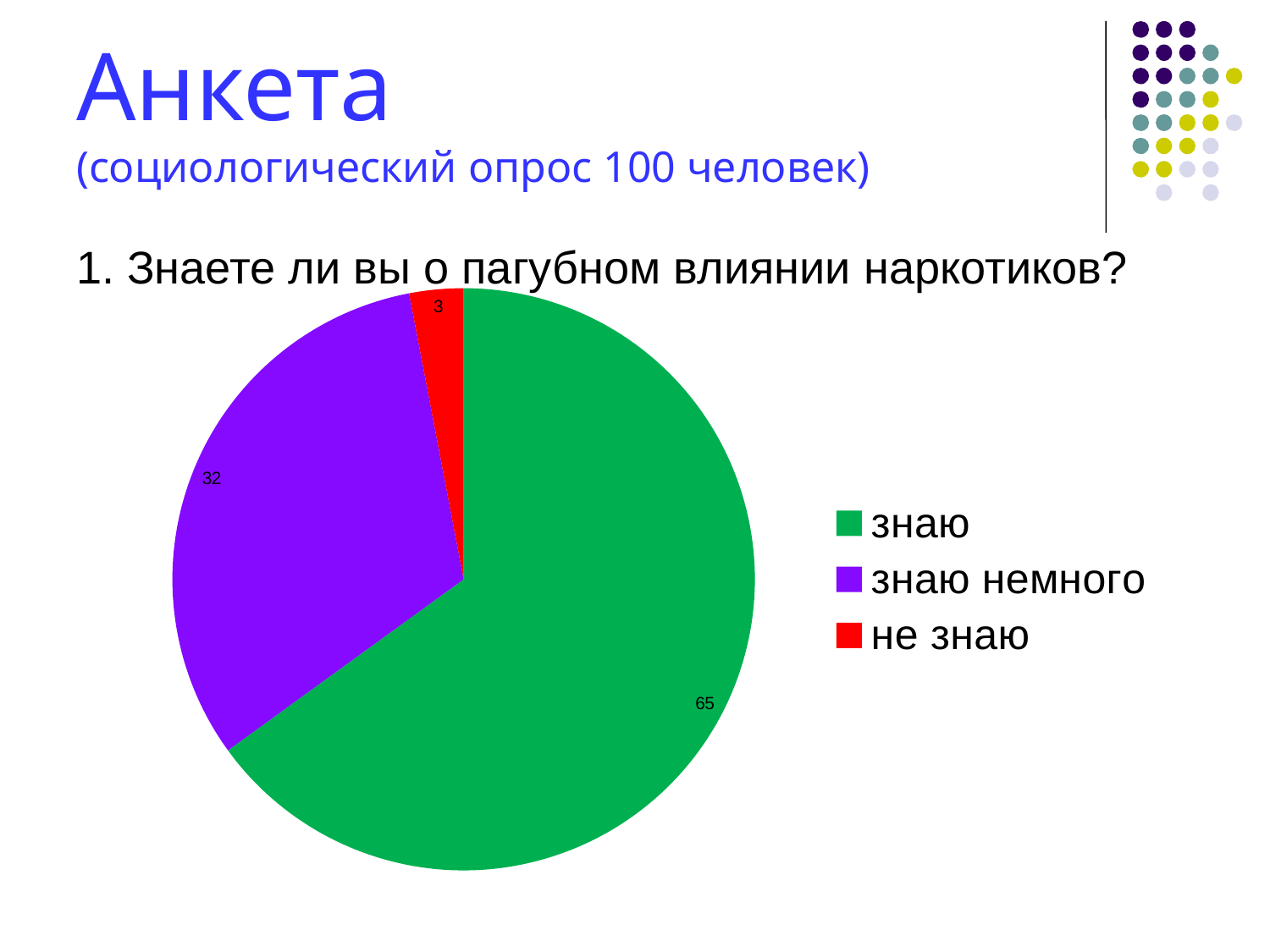
Which category has the largest slice? знаю How many slices does the pie chart have? 3 How many entries does the legend list? 3 What colour is the slice for "не знаю"? red What is the value for "знаю"? 65 What is the difference between the values for "знаю" and "знаю немного"? 33 What share of the pie does "знаю" represent? 65% What is the value for "не знаю"? 3 Which is larger, the value for "знаю немного" or the value for "не знаю"? знаю немного Which category has the smallest slice? не знаю What is the value for "знаю немного"? 32 What kind of chart is shown on the slide? pie chart